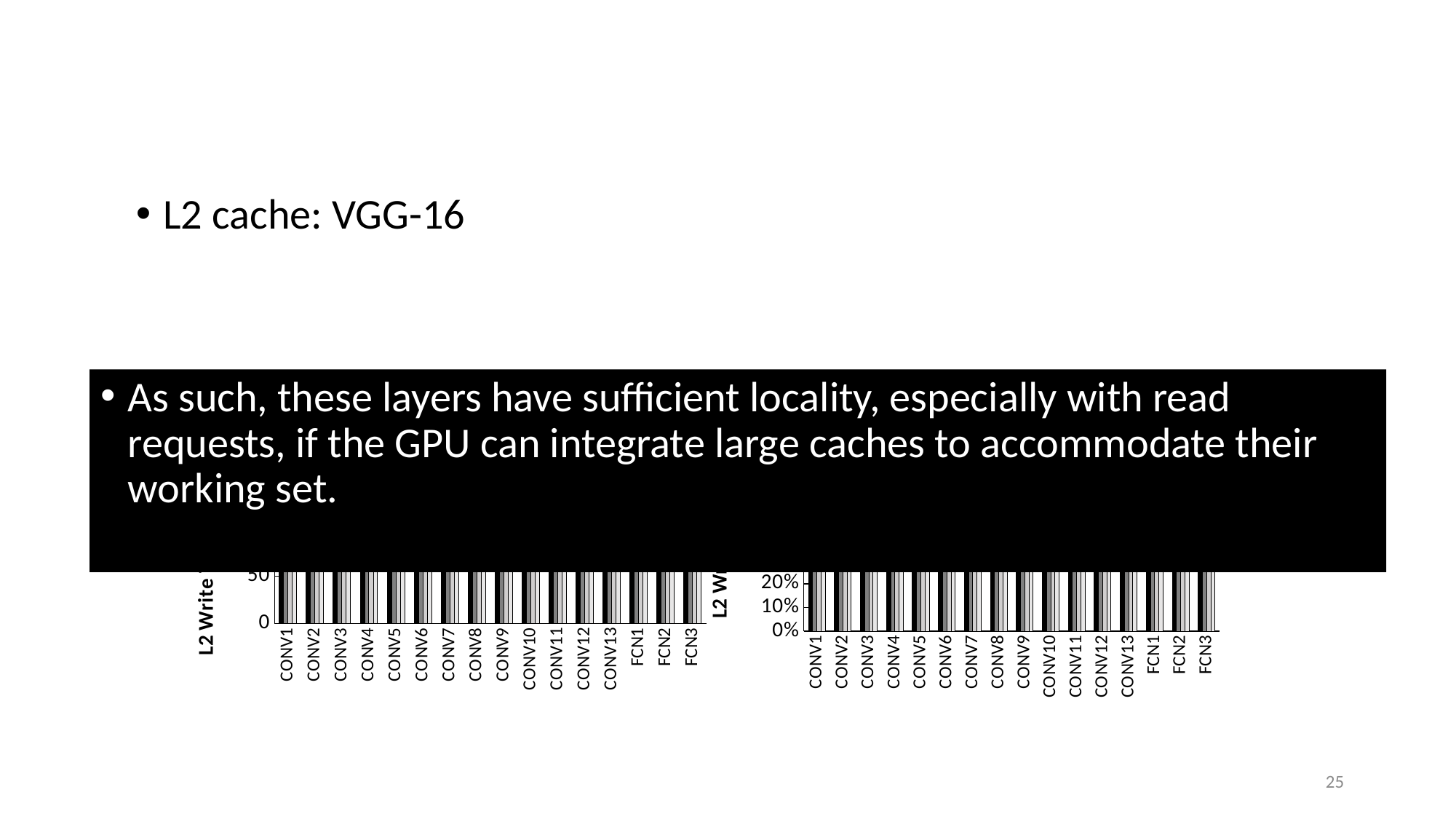
In the left chart, how many categories are shown on the x axis? 16 In the right chart, how many categories are shown on the x axis? 16 In the right chart, is the value for CONV1 greater or less than 20%? greater In the right chart, is the value for FCN3 greater or less than 10%? greater What kind of chart is the left chart? bar chart In the left chart, is the value for FCN1 greater or less than 0? greater In the right chart, what is the last category label on the x axis? FCN3 In the left chart, what is the first category label on the x axis? CONV1 What kind of chart is the right chart? bar chart